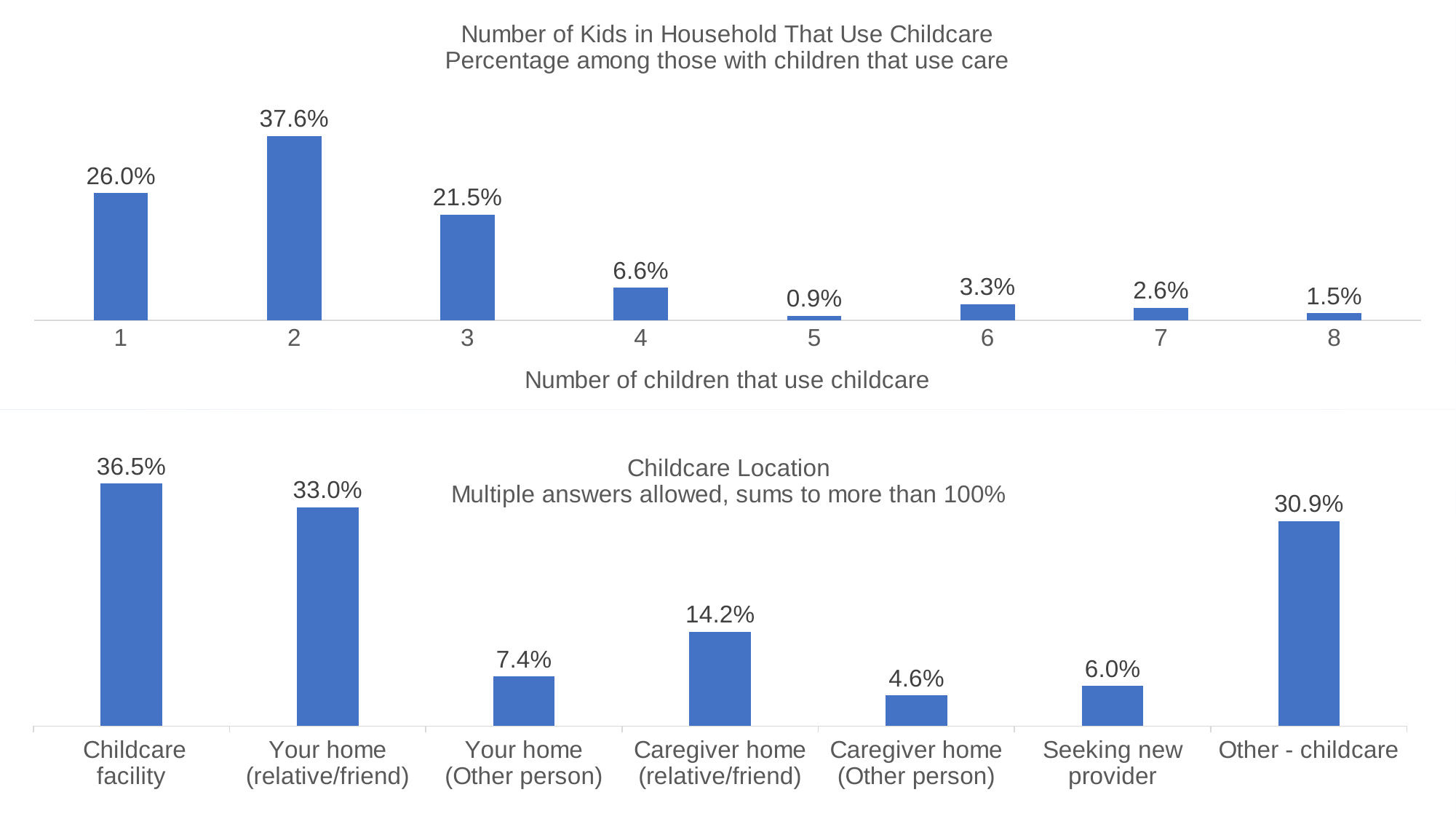
In the 'Childcare Location' chart, which location has the highest percentage? Childcare facility What type of chart is the 'Childcare Location' chart? Bar chart In the 'Number of Kids in Household That Use Childcare' chart, which number of children has the lowest percentage? 5 In the 'Number of Kids in Household That Use Childcare' chart, which number of children has the highest percentage? 2 In the 'Number of Kids in Household That Use Childcare' chart, what is the difference between the percentages for 1 child and 3 children? 4.5% In the 'Number of Kids in Household That Use Childcare' chart, which is larger, the value for 6 children or the value for 7 children? 6 children In the 'Childcare Location' chart, which location has the lowest percentage? Caregiver home (Other person) In the 'Childcare Location' chart, what is the difference between 'Childcare facility' and 'Your home (relative/friend)'? 3.5% In the 'Number of Kids in Household That Use Childcare' chart, how many categories are shown on the x axis? 8 In the 'Childcare Location' chart, what percentage is shown for 'Caregiver home (relative/friend)'? 14.2% In the 'Childcare Location' chart, how many location categories are shown? 7 In the 'Number of Kids in Household That Use Childcare' chart, what percentage is shown for 2 children? 37.6%